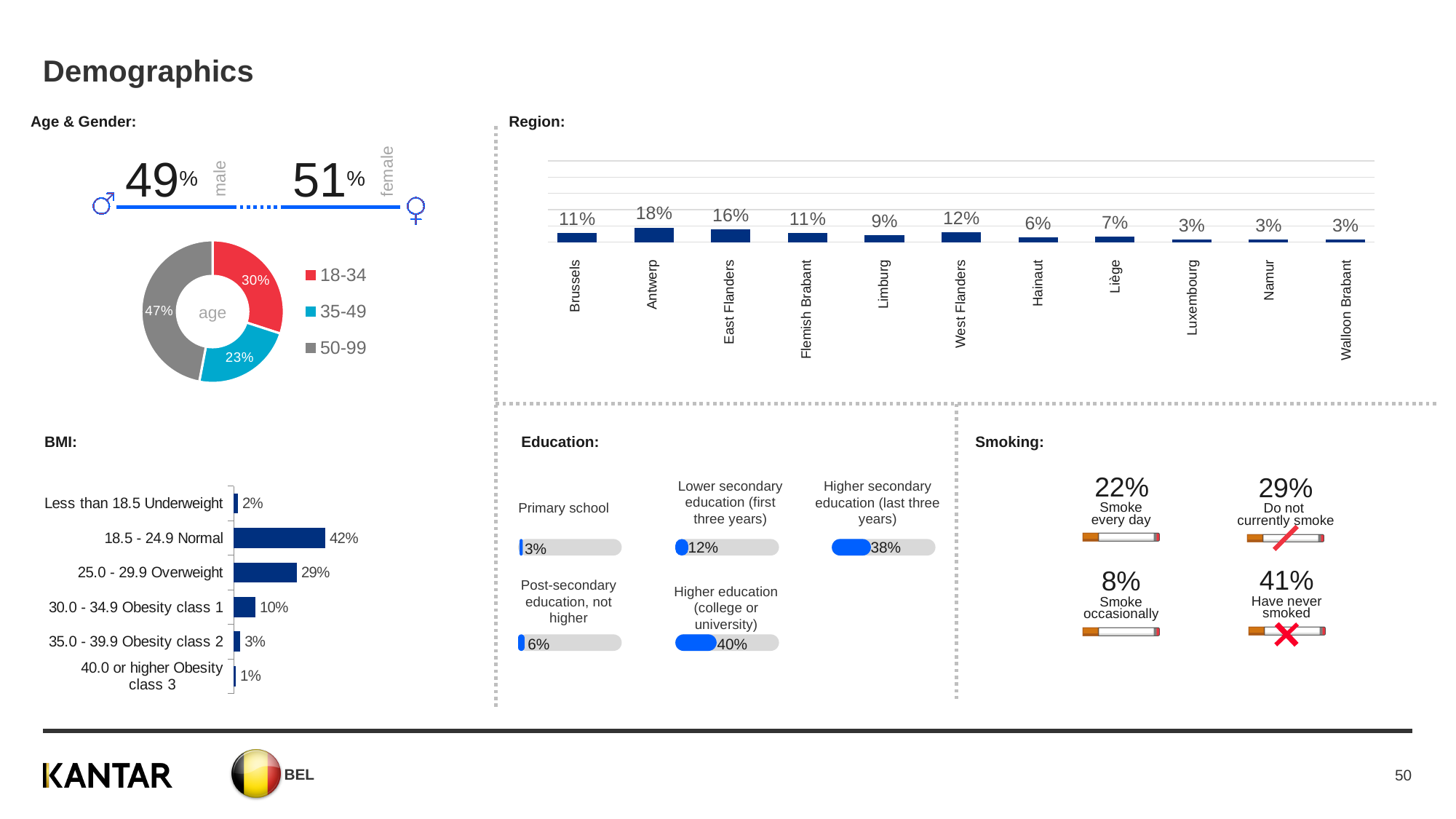
In the Region chart, which region has the highest value? Antwerp In the Region chart, what is the value for Antwerp? 18% In the Region chart, which is larger, West Flanders or Hainaut? West Flanders In the Education section, what is the value for Higher education (college or university)? 40% What kind of chart is the BMI chart? Bar chart How many categories does the legend of the age donut chart list? 3 In the age donut chart, which age group has the smallest share? 35-49 In the Region chart, what is the difference between East Flanders and Limburg? 7% In the Region chart, how many regions are shown? 11 In the BMI chart, which category has the highest value? 18.5 - 24.9 Normal In the age donut chart, what share is the 50-99 age group? 47% In the BMI chart, what is the value for 25.0 - 29.9 Overweight? 29%